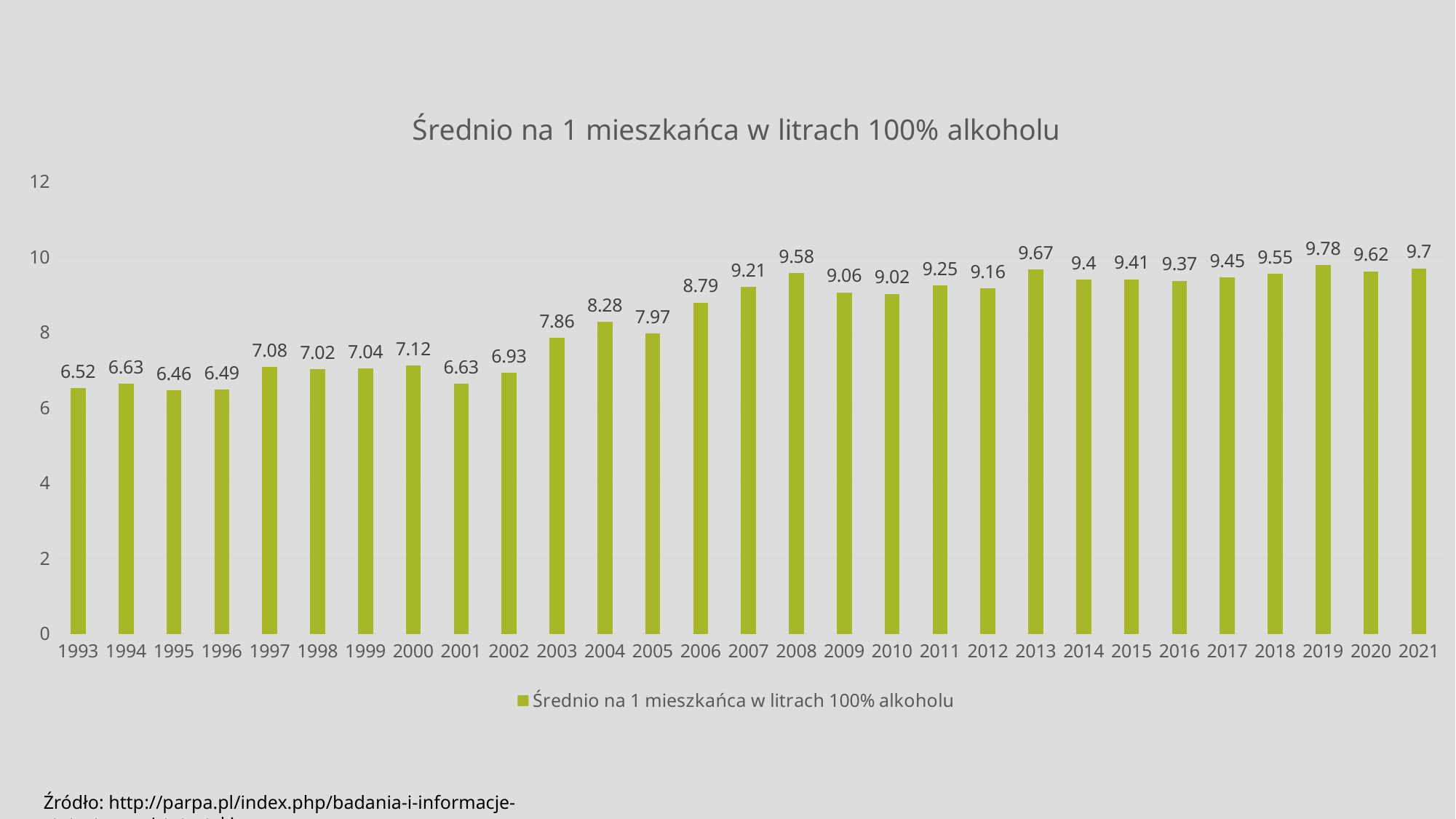
What is the value for 2008? 9.58 Which year has the highest value? 2019 What is the value for 2021? 9.7 Which year has the lowest value? 1995 How many series does the legend list? 1 What is the value for 1993? 6.52 Is the value for 2006 greater or less than 8? greater What kind of chart is this? bar chart What is the difference between the values for 2019 and 1993? 3.26 How many years are shown on the x axis? 29 What is the title of the chart? Średnio na 1 mieszkańca w litrach 100% alkoholu Which is larger, the value for 2004 or the value for 2005? 2004